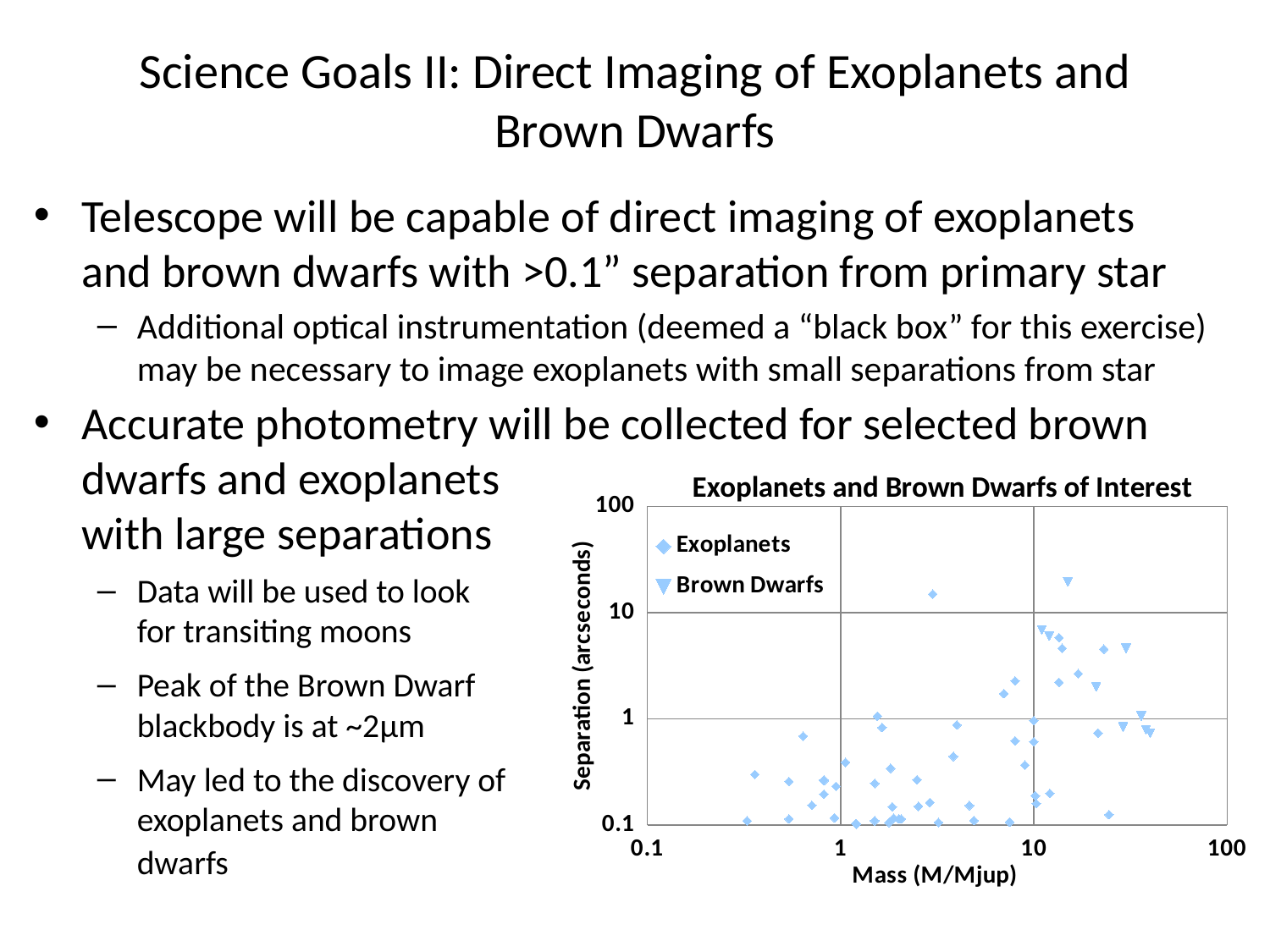
How many series does the chart's legend list? 2 What is the label of the chart's x axis? Mass (M/Mjup) What kind of chart is shown on the slide? Scatter plot Is the separation of the highest Exoplanets point greater or less than 10 arcseconds? greater Is the mass of the Exoplanets point with the highest separation greater or less than 10 M/Mjup? less Is the separation of the highest Brown Dwarfs point greater or less than 10 arcseconds? greater What are the two series named in the chart's legend? Exoplanets and Brown Dwarfs What is the highest value shown on the chart's y axis? 100 What is the label of the chart's y axis? Separation (arcseconds) What is the lowest value shown on the chart's x axis? 0.1 What is the title of the chart? Exoplanets and Brown Dwarfs of Interest